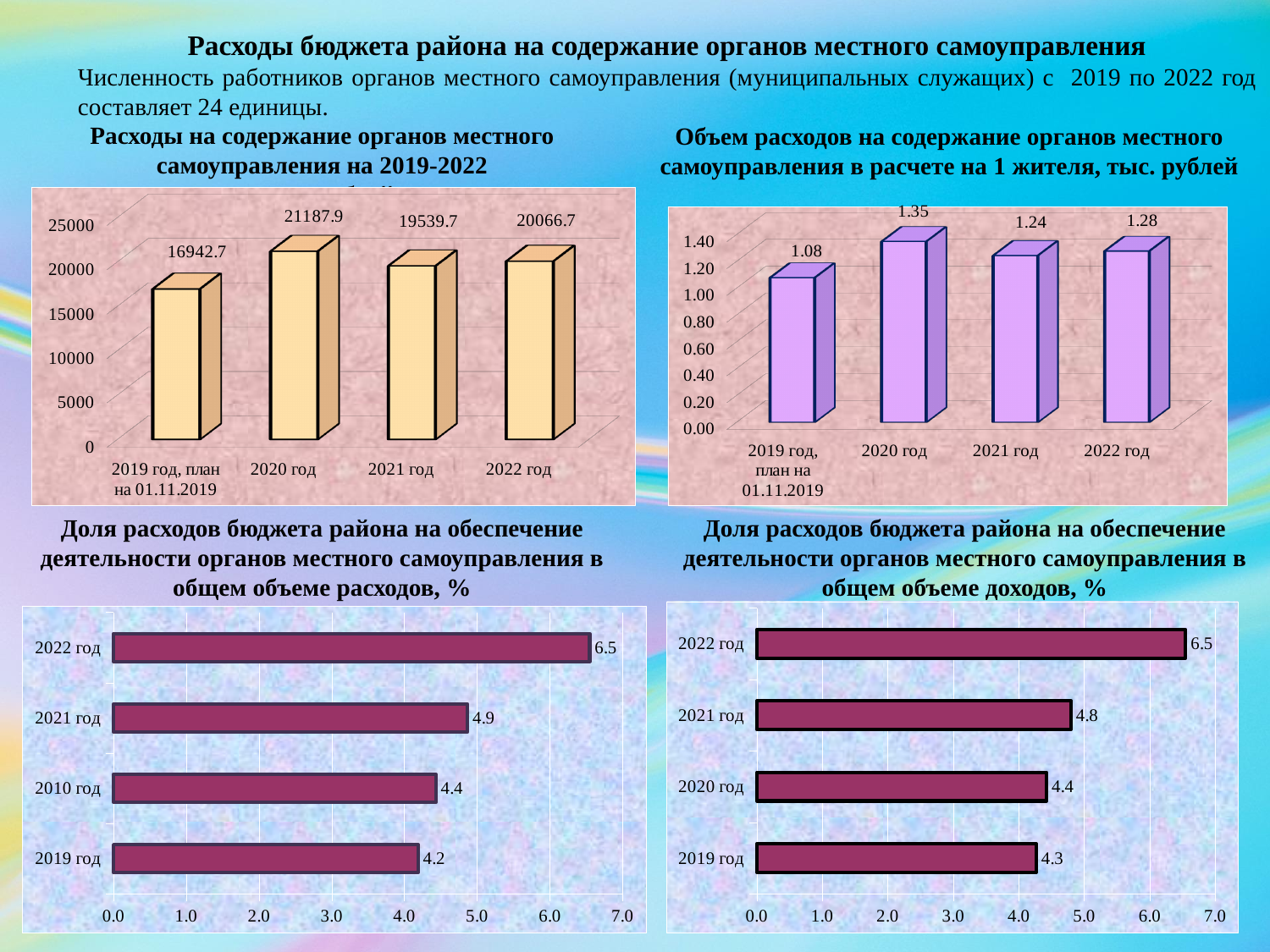
In the top-left chart (Расходы на содержание органов местного самоуправления на 2019-2022), what is the value for 2020 год? 21187.9 In the bottom-left chart (Доля расходов ... в общем объеме расходов, %), which category has the highest value? 2022 год In the top-left chart (Расходы на содержание органов местного самоуправления на 2019-2022), what is the difference between the values for 2020 год and 2021 год? 1648.2 In the bottom-left chart (Доля расходов ... в общем объеме расходов, %), what kind of chart is shown? Bar chart In the bottom-right chart (Доля расходов ... в общем объеме доходов, %), what is the difference between the values for 2022 год and 2021 год? 1.7 In the top-right chart (Объем расходов на содержание органов местного самоуправления в расчете на 1 жителя, тыс. рублей), which category has the highest value? 2020 год In the top-right chart (Объем расходов на содержание органов местного самоуправления в расчете на 1 жителя, тыс. рублей), what is the value for 2021 год? 1.24 In the top-left chart (Расходы на содержание органов местного самоуправления на 2019-2022), which category has the lowest value? 2019 год, план на 01.11.2019 In the top-right chart (Объем расходов на содержание органов местного самоуправления в расчете на 1 жителя, тыс. рублей), how many bars are plotted? 4 In the bottom-right chart (Доля расходов ... в общем объеме доходов, %), what is the value for 2019 год? 4.3 In the bottom-right chart (Доля расходов ... в общем объеме доходов, %), which is larger, the value for 2021 год or 2020 год? 2021 год In the bottom-left chart (Доля расходов ... в общем объеме расходов, %), what is the value for 2021 год? 4.9